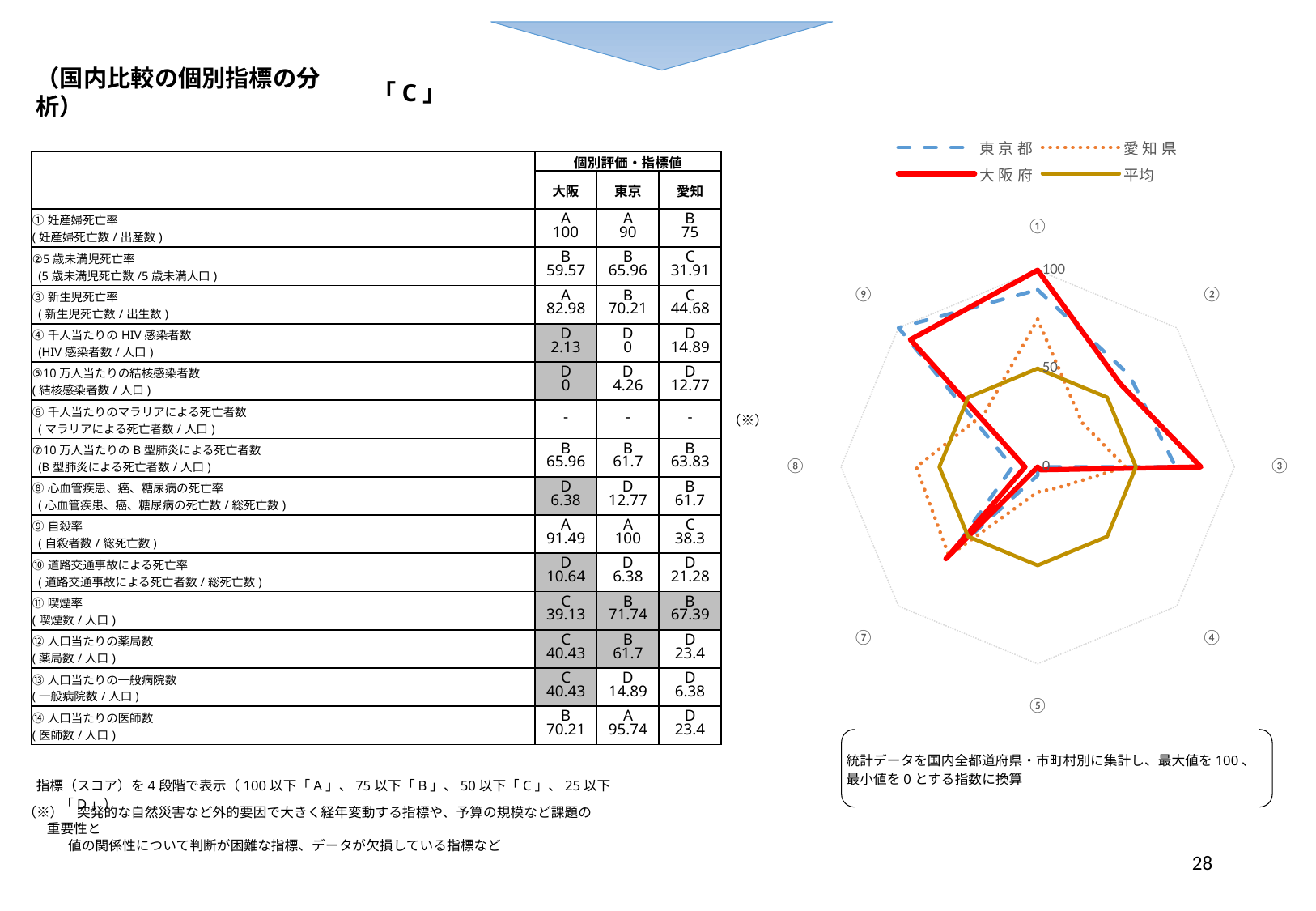
On the radar chart, which series has the highest value on axis ⑧? 愛知県 On the radar chart, which is larger on axis ③: the value for 大阪府 or the value for 愛知県? 大阪府 Which series are listed in the legend of the radar chart? 東京都, 愛知県, 大阪府, 平均 What kind of chart is shown on the right side of the slide? radar chart Which series is drawn as a solid red line in the radar chart? 大阪府 On the radar chart, is the value for 大阪府 on axis ① greater or less than 50? greater On the radar chart, which series has the highest value on axis ①? 大阪府 On the radar chart, is the value for 大阪府 on axis ③ greater or less than 50? greater What is the maximum value shown on the radar chart's axis scale? 100 How many series does the legend of the radar chart list? 4 How many axes (categories) does the radar chart have? 8 On the radar chart, is the value for 愛知県 on axis ② greater or less than 50? less